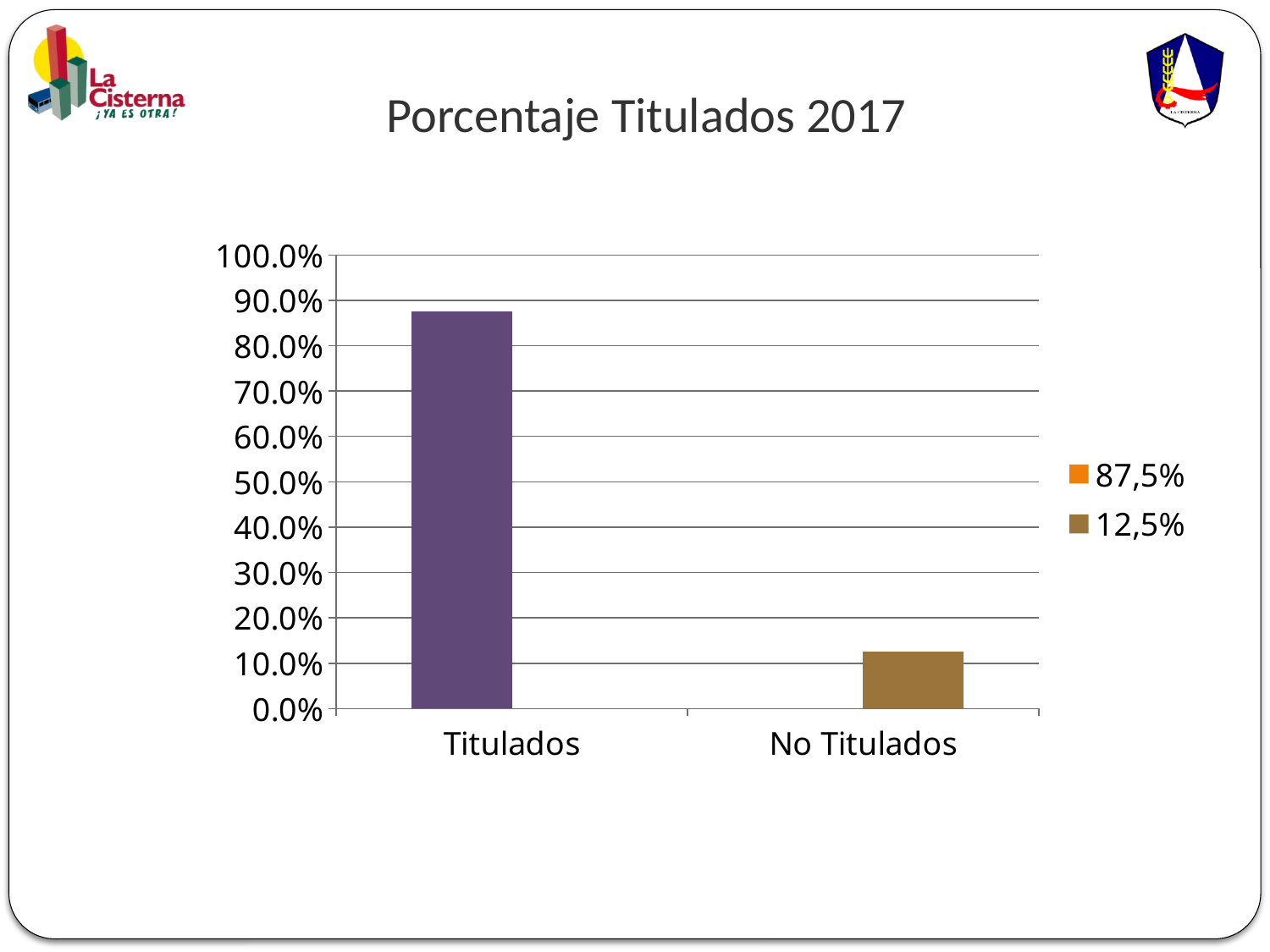
Is the value for Titulados greater or less than 80.0%? greater Which category has the highest bar in the chart? Titulados How many categories are shown on the x axis of the chart? 2 Do the bar values rise or fall moving from Titulados to No Titulados along the x axis? fall Is the value for No Titulados greater or less than 20.0%? less What kind of chart is shown on the slide? bar chart Which is larger, the value for Titulados or the value for No Titulados? Titulados What are the two entries listed in the chart's legend? 87,5% and 12,5% What is the title of the chart? Porcentaje Titulados 2017 Is the value for Titulados greater or less than 100.0%? less How many entries does the legend of the chart list? 2 Which category has the lowest bar in the chart? No Titulados